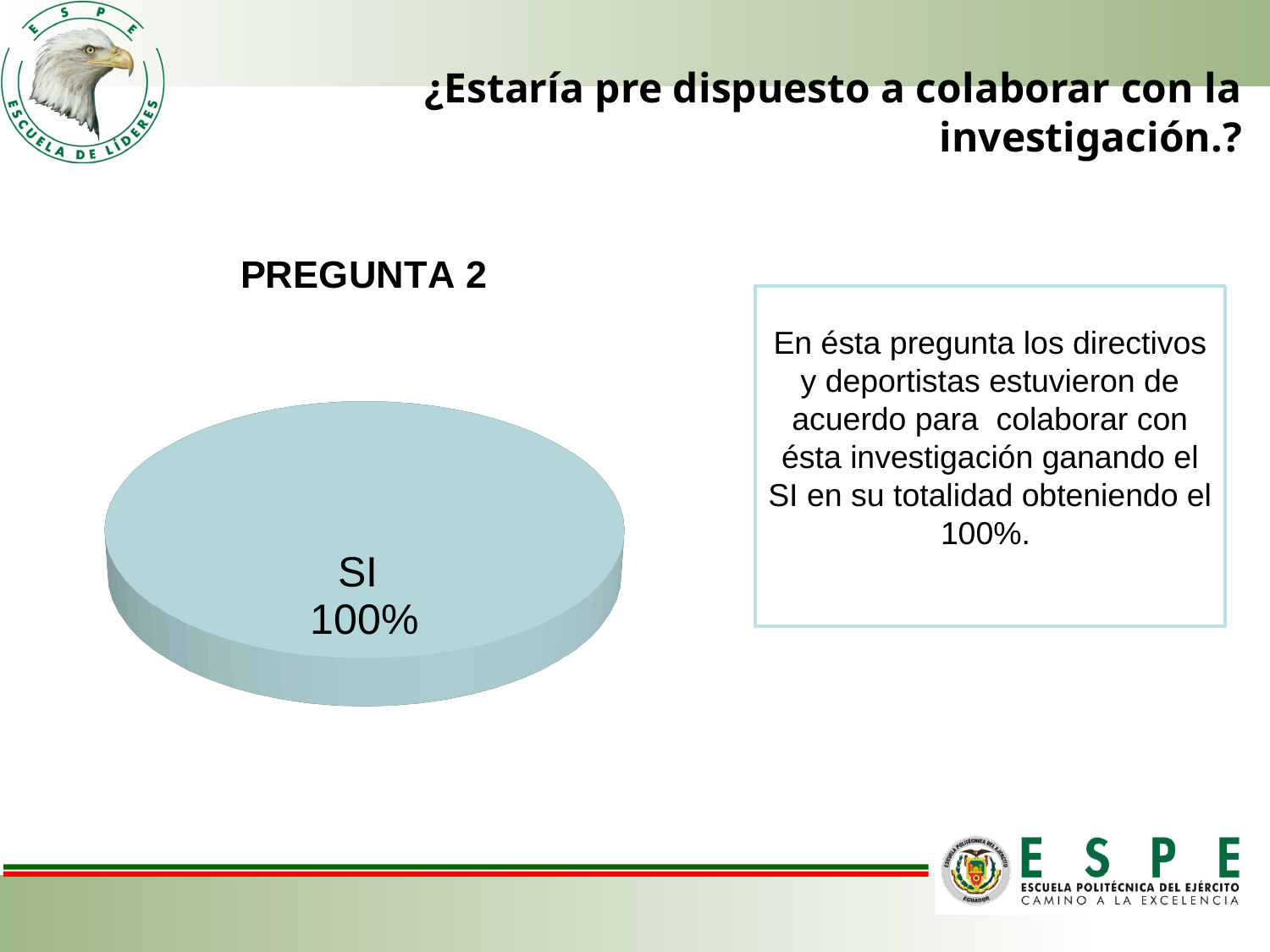
What is the title of the pie chart? PREGUNTA 2 Which category is the largest slice in the pie chart? SI What share of the pie does the SI slice represent? 100% What kind of chart is shown on the slide? pie chart Is the value for SI greater or less than 50%? greater What is the value shown for the SI category in the pie chart? 100% How many slices does the pie chart have? 1 What is the label of the only slice in the pie chart? SI